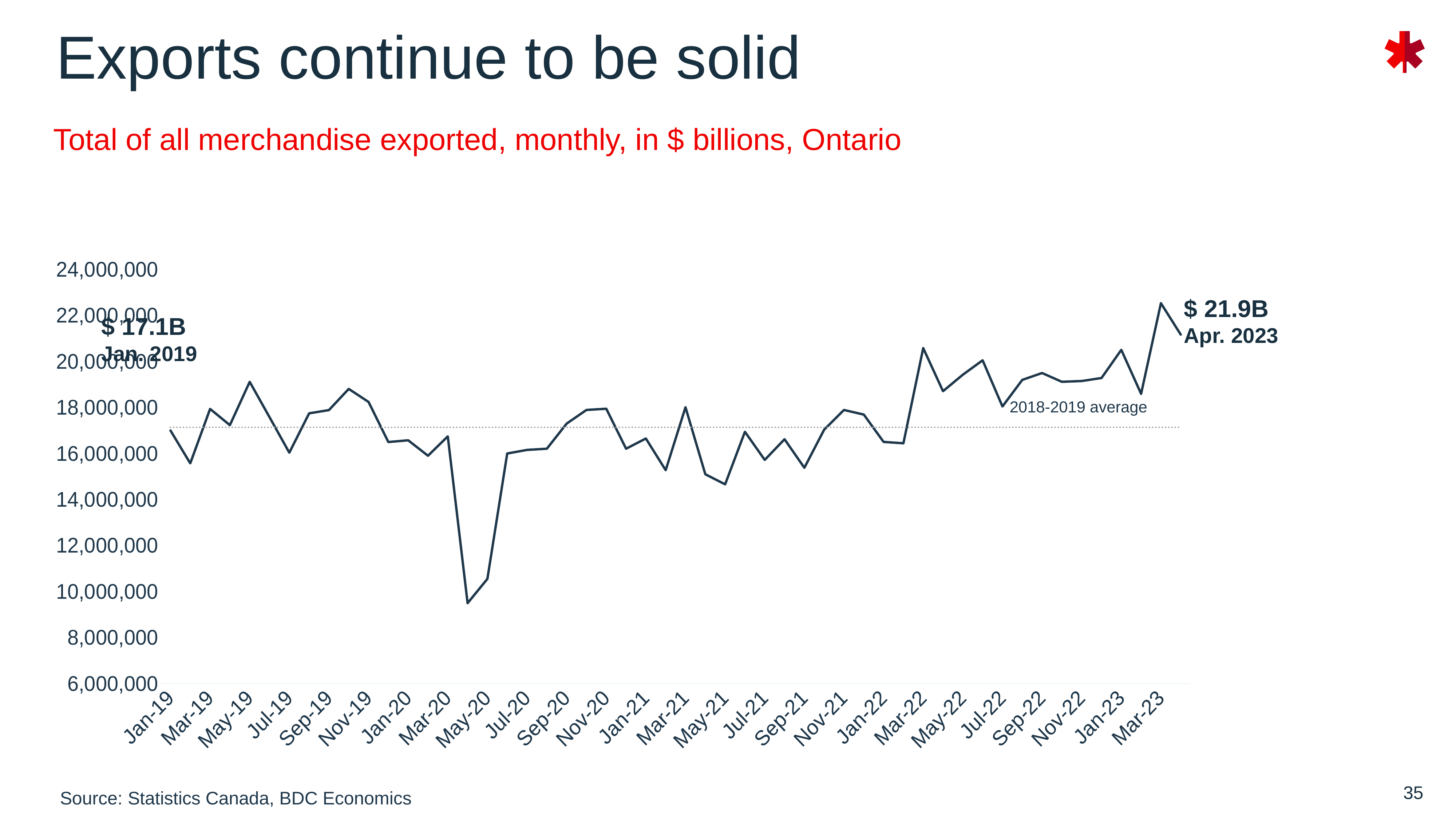
Is the Jan. 2019 value greater or less than 18,000,000? less Is the dotted 2018-2019 average line above or below 18,000,000? below By how much does the labelled Apr. 2023 value exceed the labelled Jan. 2019 value? $ 4.8B What kind of chart is shown on the slide? line chart How many month labels are shown on the x axis? 26 What was the value of Ontario merchandise exports in Apr. 2023, as labelled on the chart? $ 21.9B What does the dotted horizontal line on the chart represent? 2018-2019 average Is the lowest point on the line greater or less than 10,000,000? less What was the value of Ontario merchandise exports in Jan. 2019, as labelled on the chart? $ 17.1B Which labelled value is larger: Jan. 2019 or Apr. 2023? Apr. 2023 Overall, do exports rise or fall from Jan-19 to Apr-23? rise